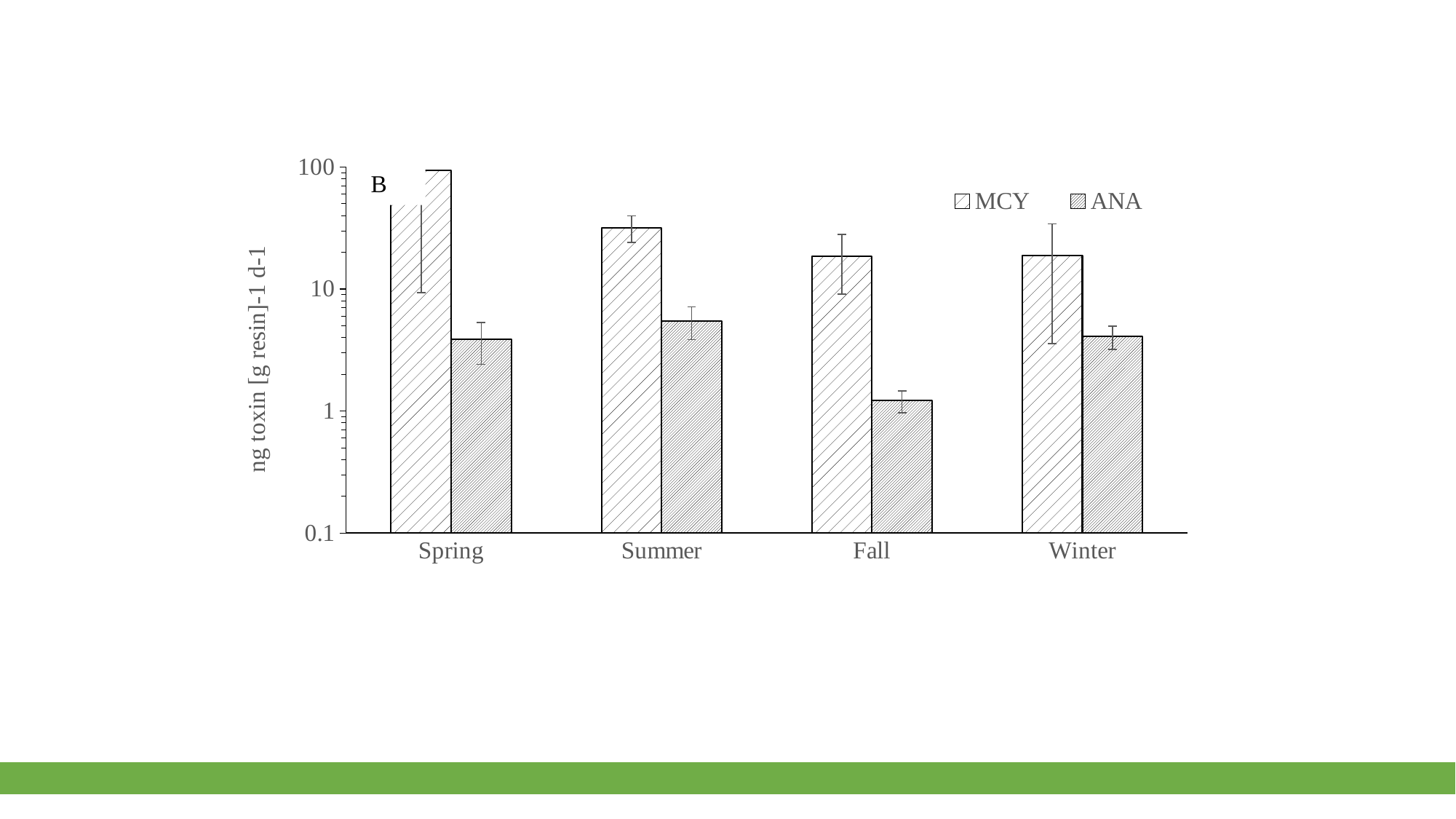
In Spring, which series has the larger value, MCY or ANA? MCY What is the label on the y axis? ng toxin [g resin]-1 d-1 How many series does the legend list? 2 How many seasons (categories) are shown on the x axis? 4 What kind of chart is shown on the slide? bar chart Is the MCY value for Summer greater or less than 10? greater Is the ANA value for Spring greater or less than 1? greater Does the MCY value rise or fall from Spring to Summer? fall Which season has the highest MCY value? Spring Which season has the lowest ANA value? Fall Is the ANA value for Fall greater or less than 10? less In Fall, which series has the larger value, MCY or ANA? MCY